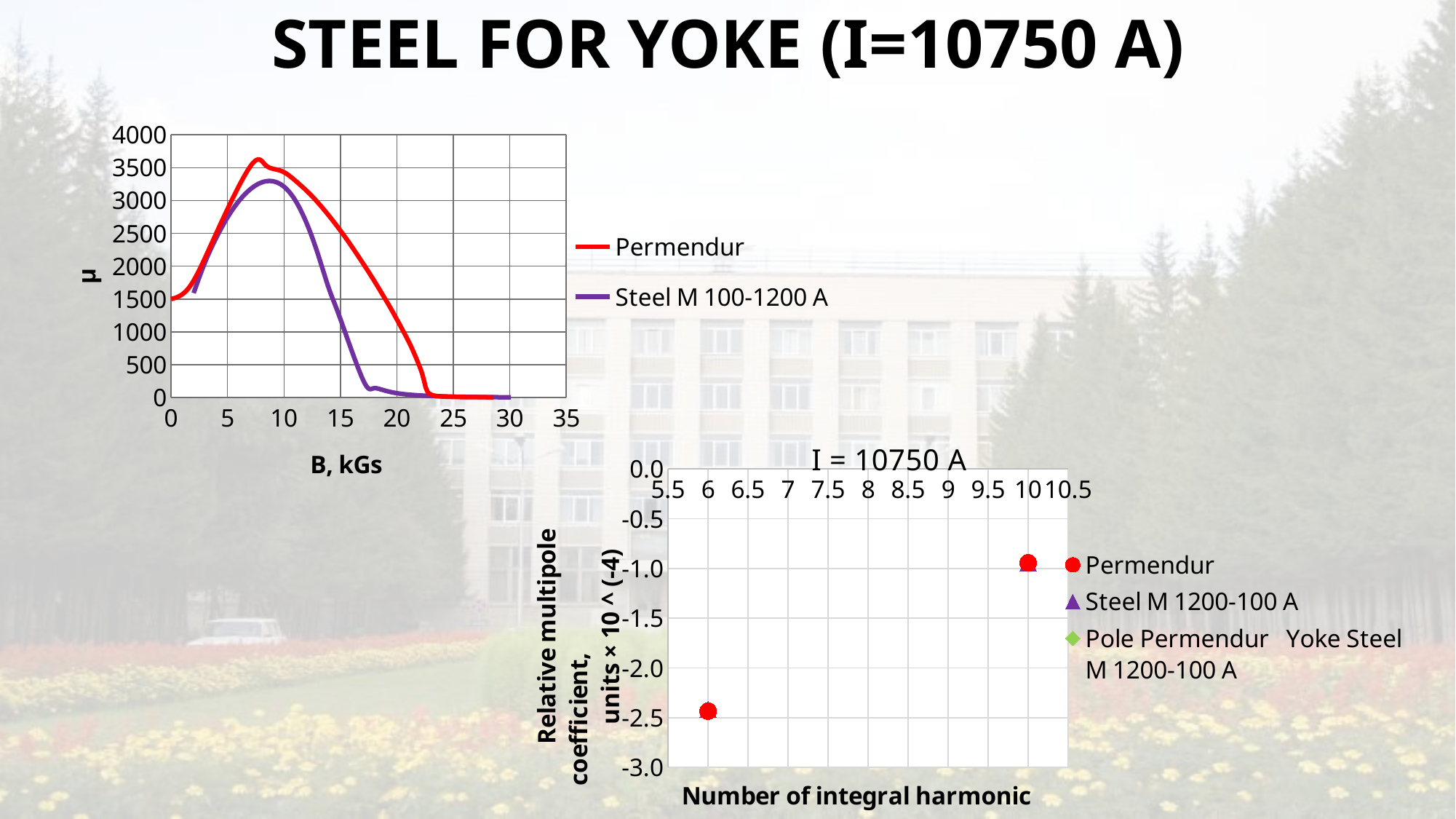
In the top-left chart, which series reaches the higher peak value of μ? Permendur In the top-left chart, do the μ values rise or fall as B increases from 10 to 20 kGs? fall In the top-left chart, is the peak value of the Permendur curve greater or less than 3500? greater What is the title of the bottom-right chart? I = 10750 A In the bottom-right chart, which plotted harmonic number has the higher value, 6 or 10? 10 What is the x-axis title of the top-left chart? B, kGs What kind of chart is the top-left chart with the B, kGs axis? line chart How many series does the legend of the top-left chart list? 2 In the bottom-right chart, is the value plotted at harmonic number 6 greater or less than -2.0? less In the top-left chart, is the Permendur value at B = 25 kGs greater or less than 500? less How many series does the legend of the bottom-right chart list? 3